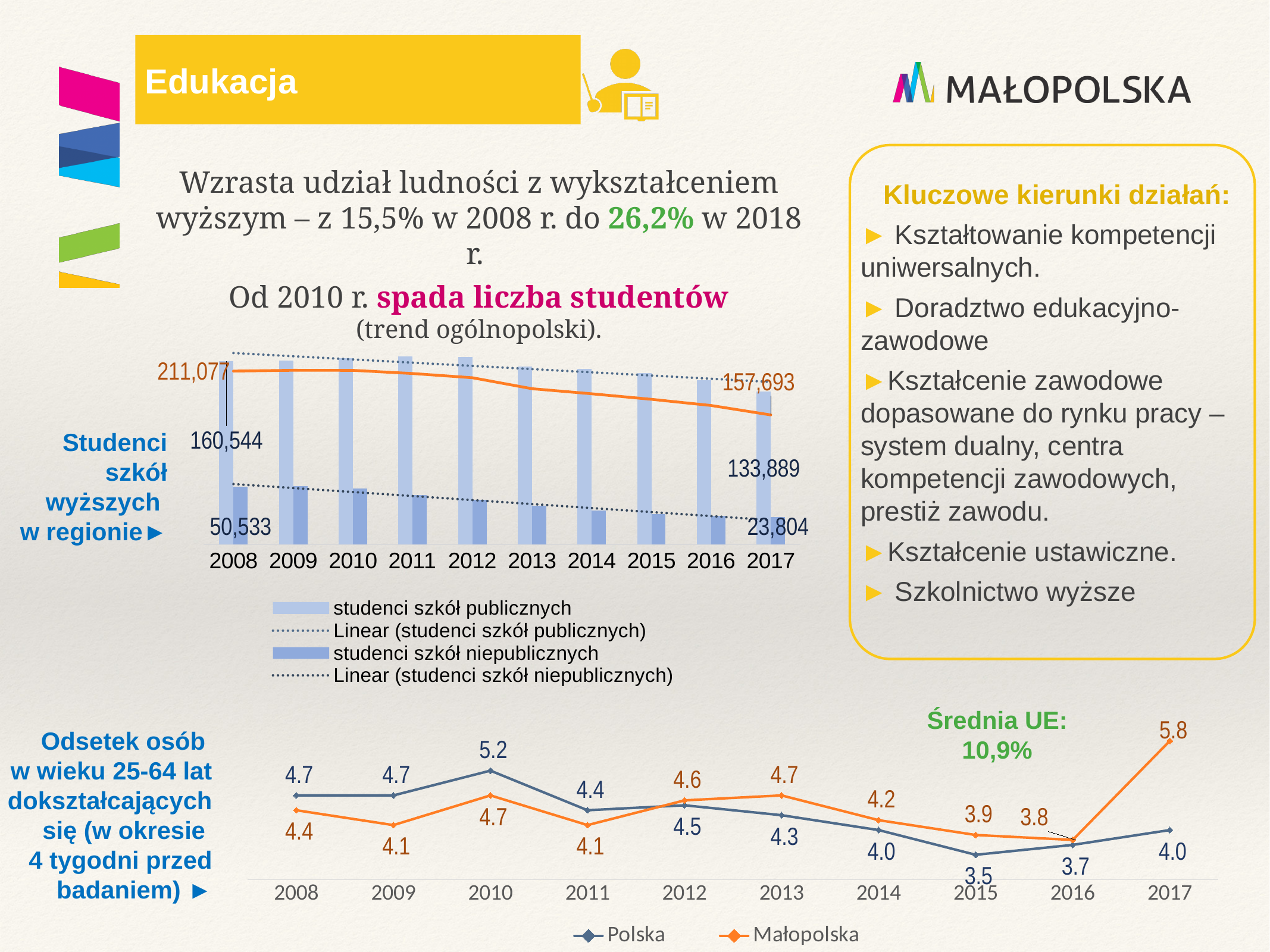
In the top chart (Studenci szkół wyższych w regionie), how many years are shown on the x axis? 10 In the top chart (Studenci szkół wyższych w regionie), what is the value for students of non-public schools (studenci szkół niepublicznych) in 2017? 23,804 In the top chart (Studenci szkół wyższych w regionie), do the bars for students of non-public schools rise or fall from 2008 to 2017? fall In the bottom chart (Odsetek osób w wieku 25-64 lat dokształcających się), in which year is the value for Polska lowest? 2015 In the top chart (Studenci szkół wyższych w regionie), how many students of public schools (studenci szkół publicznych) were there in 2008? 160,544 In the bottom chart (Odsetek osób w wieku 25-64 lat dokształcających się), what is the difference between Małopolska and Polska in 2017? 1.8 In the top chart (Studenci szkół wyższych w regionie), how many entries does the legend list? 4 What kind of chart is the bottom chart (Odsetek osób w wieku 25-64 lat dokształcających się)? line chart In the top chart (Studenci szkół wyższych w regionie), by how much did the number of students of public schools fall between 2008 and 2017? 26,655 In the bottom chart (Odsetek osób w wieku 25-64 lat dokształcających się), in which year is the value for Polska highest? 2010 In the bottom chart (Odsetek osób w wieku 25-64 lat dokształcających się), which series has the higher value in 2013, Polska or Małopolska? Małopolska In the bottom chart (Odsetek osób w wieku 25-64 lat dokształcających się), what is the value for Małopolska in 2017? 5.8